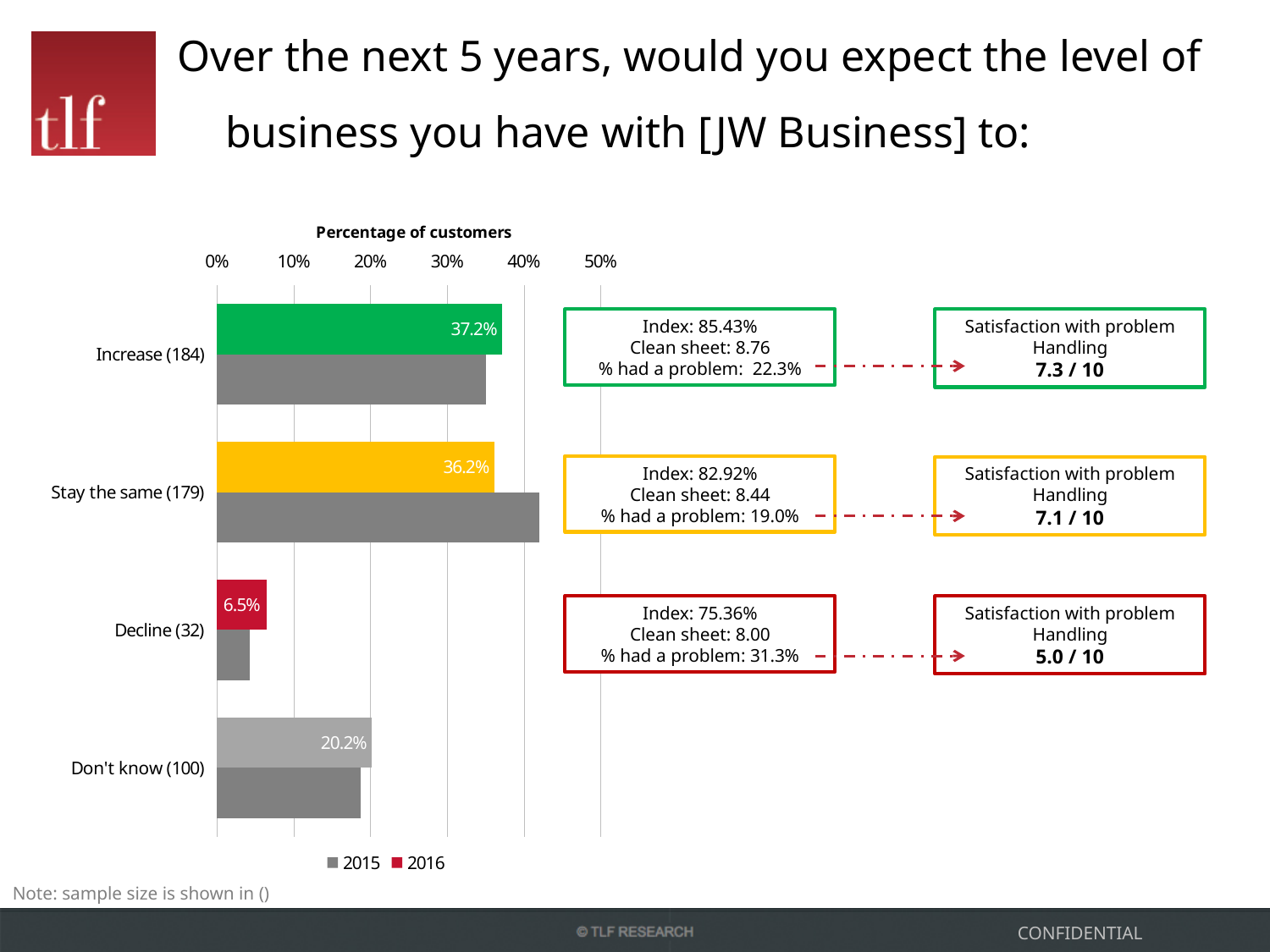
Which category has the highest 2016 value? Increase (184) What is the difference between the 2016 values for Increase (184) and Don't know (100)? 17.0% How many series does the legend list? 2 Which category has the lowest 2016 value? Decline (32) Is the 2015 value for Stay the same (179) greater or less than 40%? greater What is the 2016 value for Decline (32)? 6.5% Which is larger for Stay the same (179): the 2015 value or the 2016 value? 2015 Is the 2015 value for Decline (32) greater or less than 10%? less What is the 2016 value for Don't know (100)? 20.2% How many categories are shown on the chart? 4 What kind of chart is shown on the slide? Bar chart What is the 2016 value for Increase (184)? 37.2%